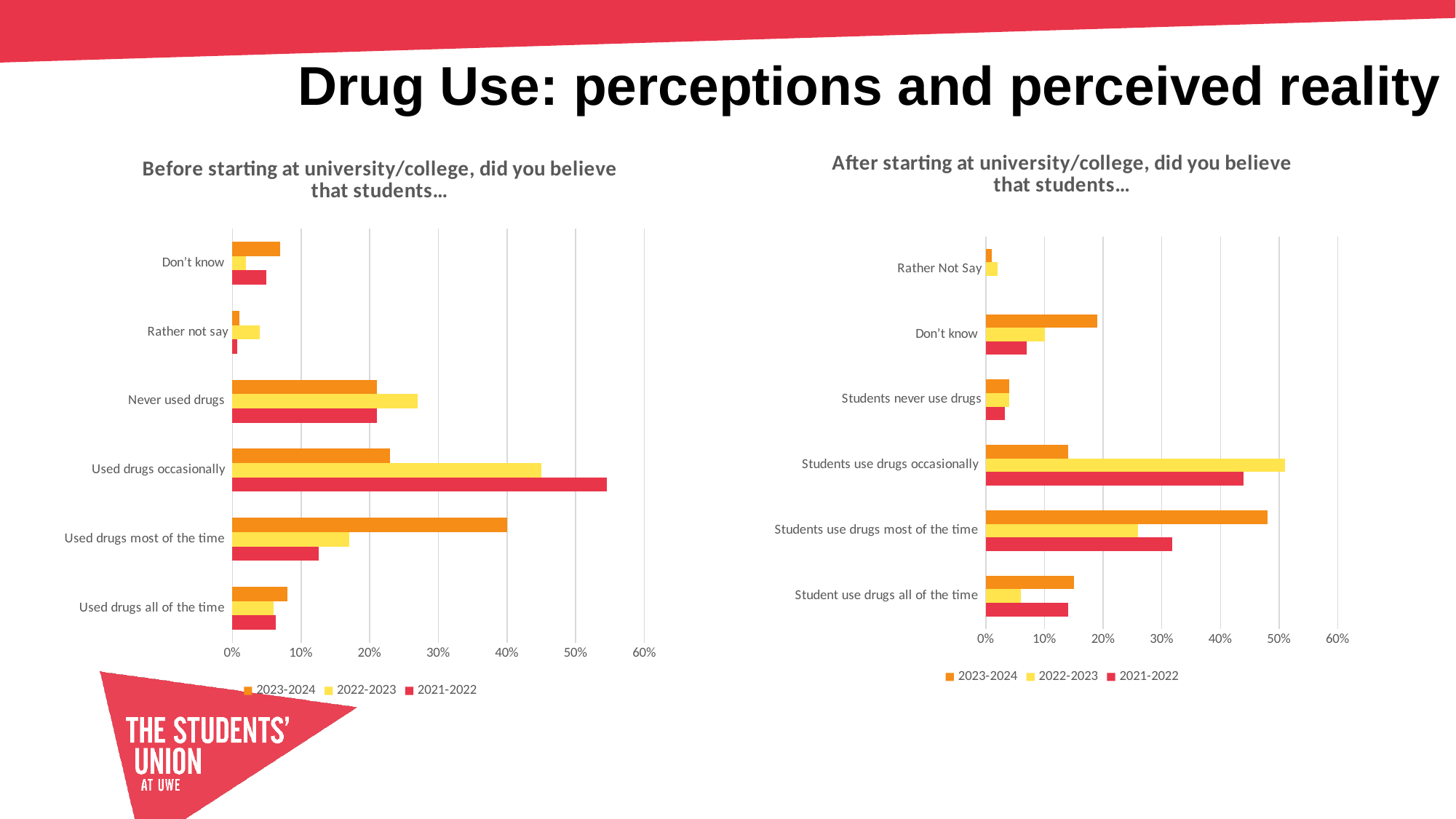
On the right chart ("After starting…"), which category has the highest 2022-2023 value? Students use drugs occasionally How many categories are shown on the right chart ("After starting at university/college…")? 6 On the left chart ("Before starting…"), which colour represents the 2021-2022 series in the legend? Red On the right chart ("After starting…"), which category has the highest 2023-2024 value? Students use drugs most of the time On the right chart ("After starting…"), is the 2023-2024 value for "Students use drugs occasionally" greater or less than 20%? less On the left chart ("Before starting…"), which category has the highest 2021-2022 value? Used drugs occasionally On the left chart ("Before starting…"), is the 2023-2024 value for "Used drugs most of the time" greater or less than 30%? greater On the left chart ("Before starting…"), is the 2021-2022 value for "Used drugs occasionally" greater or less than 50%? greater What kind of chart is the left chart titled "Before starting at university/college, did you believe that students…"? Bar chart How many series does the legend of the right chart ("After starting at university/college…") list? 3 How many categories are shown on the left chart ("Before starting at university/college…")? 6 On the right chart ("After starting…"), for "Students use drugs most of the time", which series is larger: 2023-2024 or 2022-2023? 2023-2024